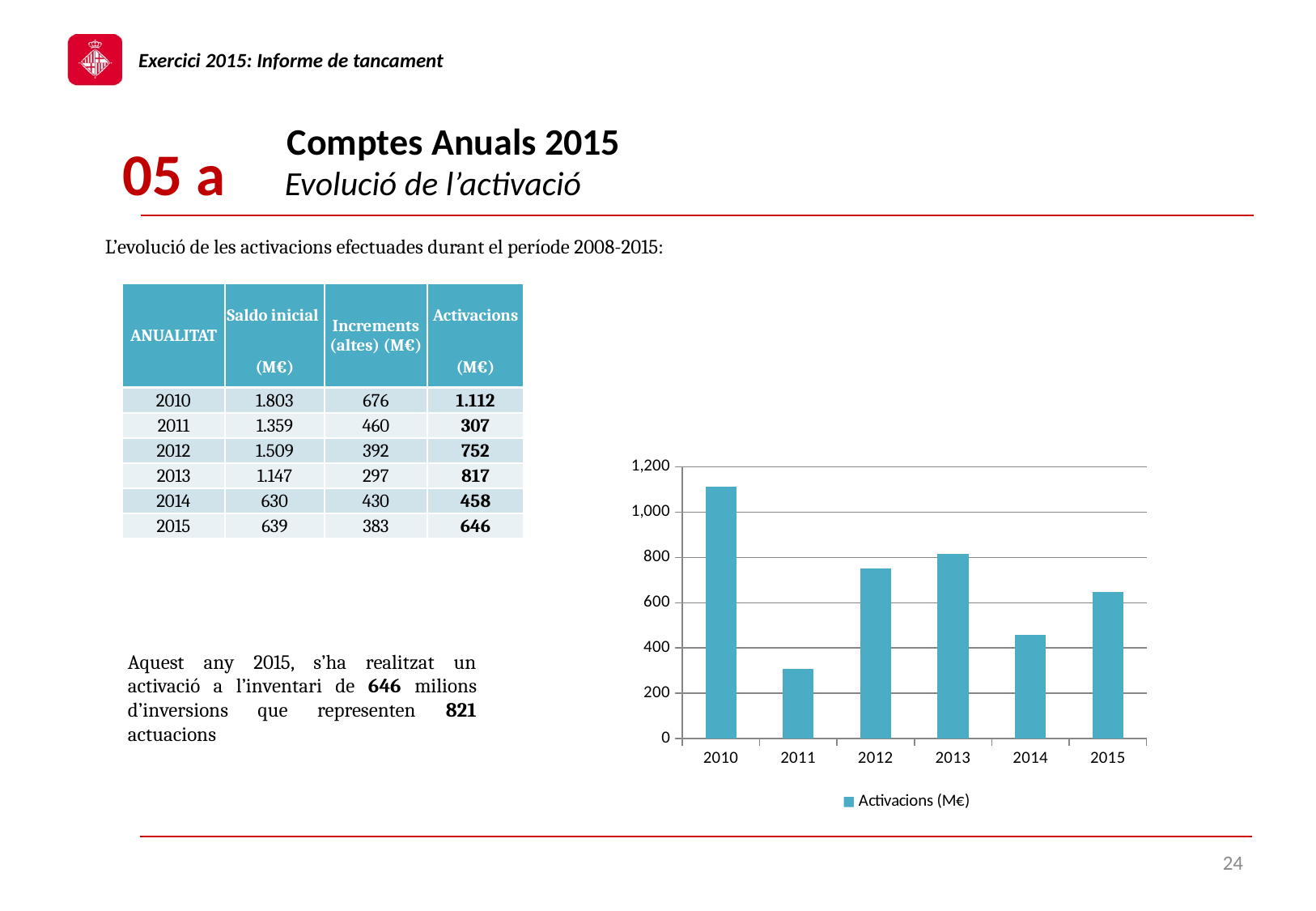
Is the Activacions (M€) value for 2010 greater or less than 1,000? greater What is the legend entry of the chart? Activacions (M€) How many series does the chart legend list? 1 Which year has the larger Activacions (M€) bar, 2012 or 2014? 2012 Which year has the larger Activacions (M€) bar, 2015 or 2013? 2013 Do the Activacions (M€) bars rise or fall from 2013 to 2014? fall Is the Activacions (M€) value for 2013 greater or less than 800? greater Which year has the highest Activacions (M€) bar? 2010 Which year has the lowest Activacions (M€) bar? 2011 How many years are plotted on the x axis of the chart? 6 What kind of chart is shown on the slide? bar chart Is the Activacions (M€) value for 2011 greater or less than 400? less